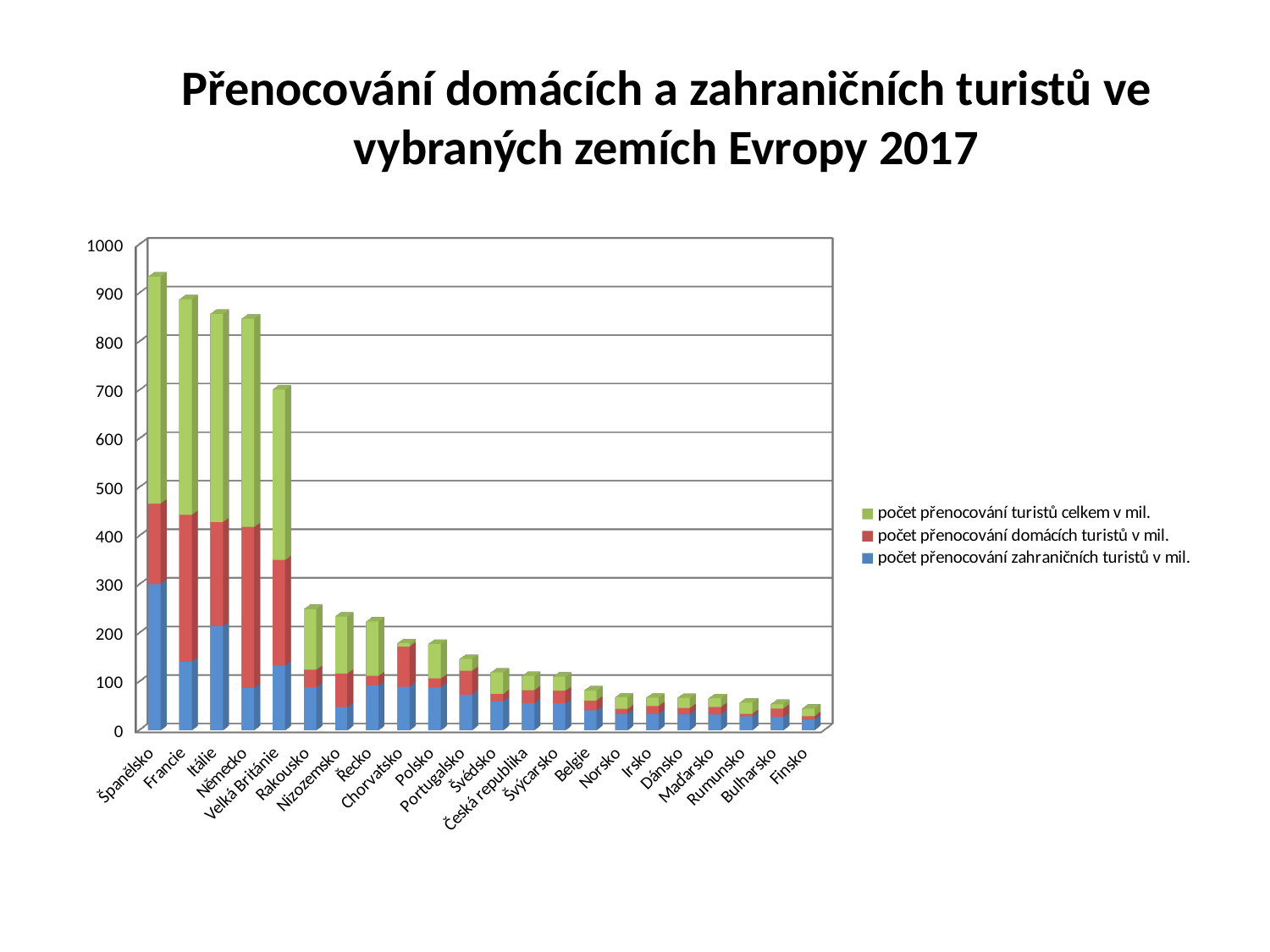
Do the stacked bar heights rise or fall moving from left to right along the x axis? fall What kind of chart is shown on the slide? stacked bar chart Which has the taller stacked bar, Španělsko or Francie? Španělsko How many series does the legend list? 3 Is the blue segment (počet přenocování zahraničních turistů v mil.) for Itálie greater or less than 200? greater Is the top of the stacked bar for Španělsko greater or less than 900? greater Which country has the shortest stacked bar? Finsko How many countries are shown on the x axis of the chart? 22 Which series is shown in green in the legend? počet přenocování turistů celkem v mil. Is the top of the stacked bar for Francie greater or less than 900? less Which country has the tallest stacked bar? Španělsko